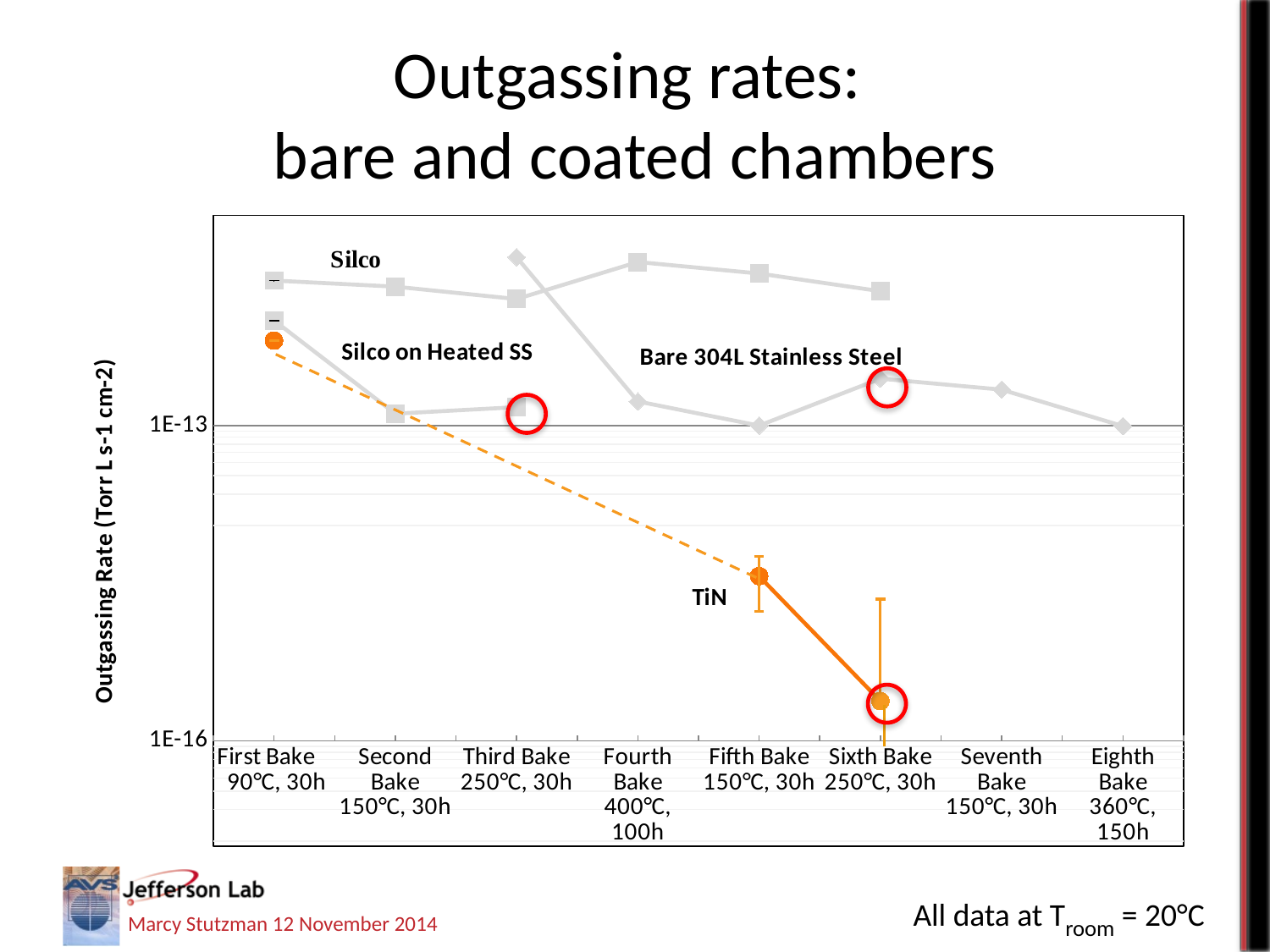
Is the TiN value at Fifth Bake greater or less than 1E-13? less Which series has the lowest value at Sixth Bake? TiN Is the Silco value at First Bake greater or less than 1E-13? greater How many data series are labelled on the chart? 4 What is the y-axis title of the chart? Outgassing Rate (Torr L s-1 cm-2) At First Bake, which is larger: the Silco value or the Silco on Heated SS value? Silco What kind of chart is shown on the slide? line chart Does the Bare 304L Stainless Steel series rise or fall from Third Bake to Fourth Bake? fall How many bake categories are shown on the x axis? 8 Is the TiN value at Sixth Bake greater or less than 1E-13? less At Sixth Bake, which is larger: the Silco value or the TiN value? Silco Does the TiN series rise or fall from Fifth Bake to Sixth Bake? fall